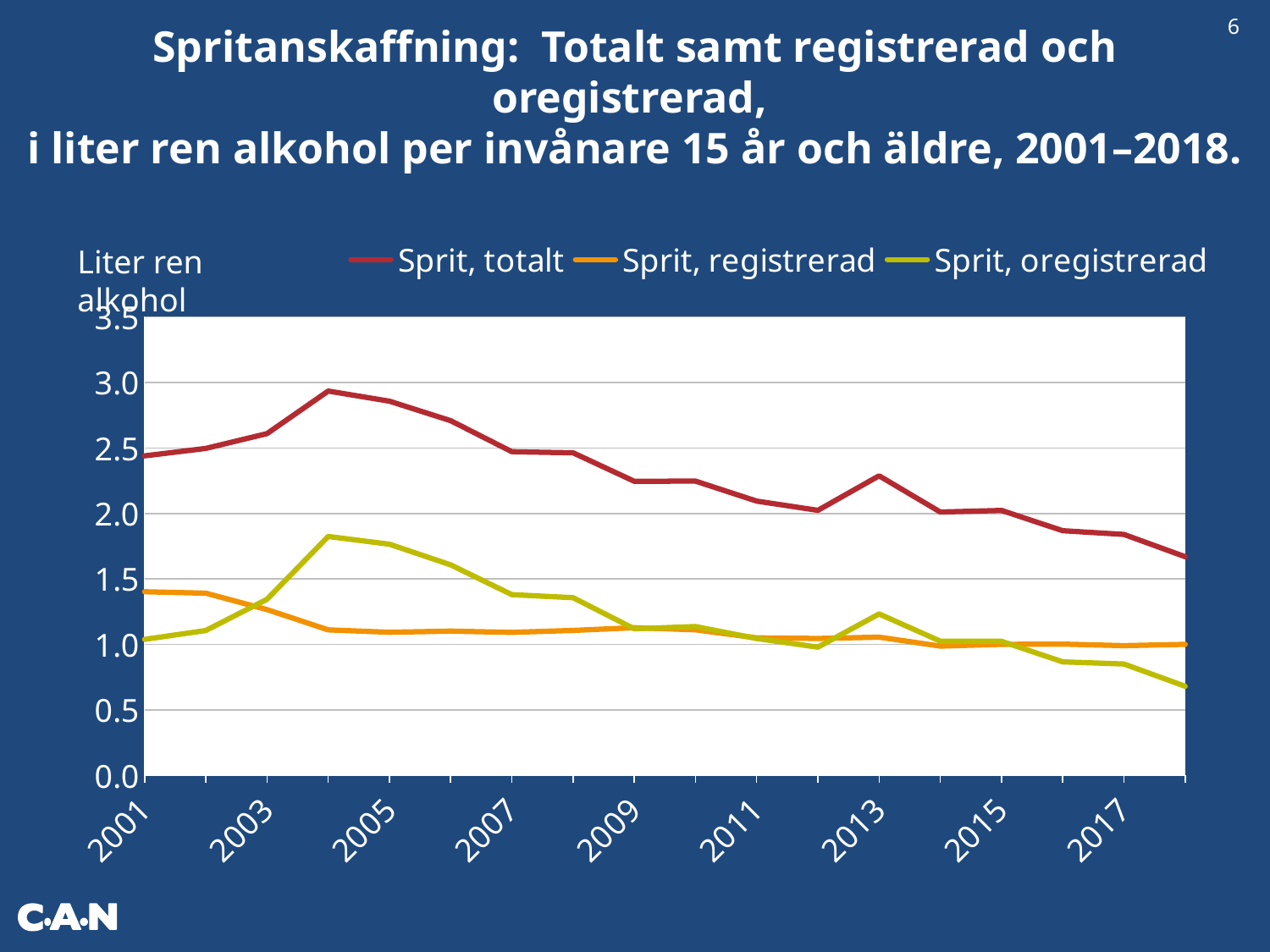
What kind of chart is shown on the slide? Line chart Is the value for Sprit, oregistrerad in 2018 greater or less than 1.0? less In which year does Sprit, oregistrerad reach its highest value? 2004 Is the value for Sprit, totalt in 2018 greater or less than 2.0? less In which year is Sprit, totalt at its lowest? 2018 Does Sprit, totalt rise or fall from 2004 to 2018? Fall Which series are listed in the legend? Sprit, totalt; Sprit, registrerad; Sprit, oregistrerad What is the label on the vertical axis? Liter ren alkohol In which year does Sprit, totalt reach its highest value? 2004 In 2004, which is larger: Sprit, registrerad or Sprit, oregistrerad? Sprit, oregistrerad How many series does the legend list? 3 Is the value for Sprit, totalt in 2004 greater or less than 2.5? greater